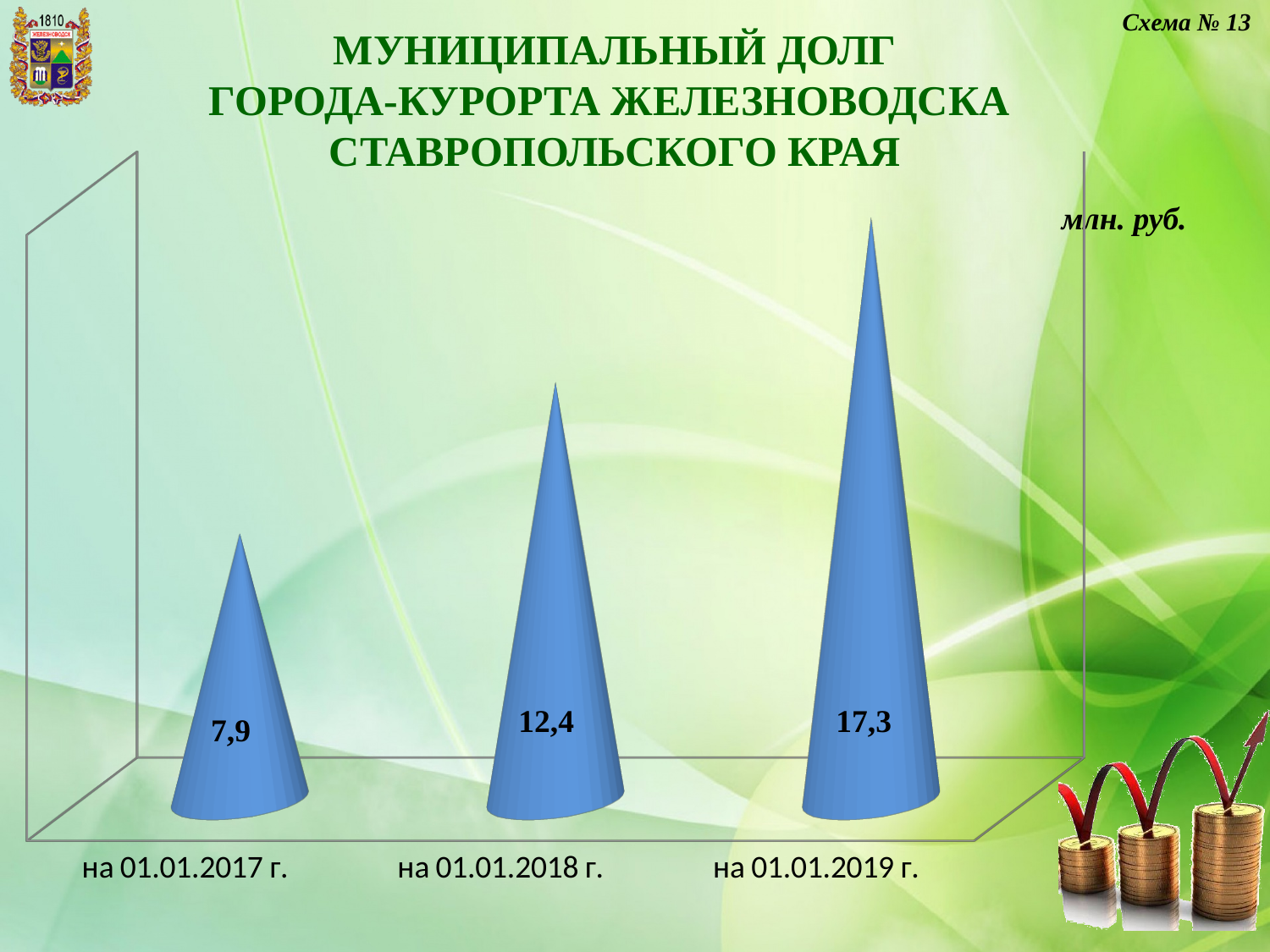
Which is larger, the value for на 01.01.2018 г. or the value for на 01.01.2019 г.? на 01.01.2019 г. What is the difference between the values for на 01.01.2018 г. and на 01.01.2017 г.? 4,5 Which date has the highest municipal debt value? на 01.01.2019 г. What is the municipal debt value shown for на 01.01.2017 г.? 7,9 What unit of measurement is indicated on the chart? млн. руб. What is the difference between the values for на 01.01.2019 г. and на 01.01.2017 г.? 9,4 How many dates are shown on the chart? 3 Which date has the lowest municipal debt value? на 01.01.2017 г. What is the municipal debt value shown for на 01.01.2018 г.? 12,4 What kind of chart is shown on the slide? bar chart Do the values rise or fall from на 01.01.2017 г. to на 01.01.2019 г.? rise What is the municipal debt value shown for на 01.01.2019 г.? 17,3